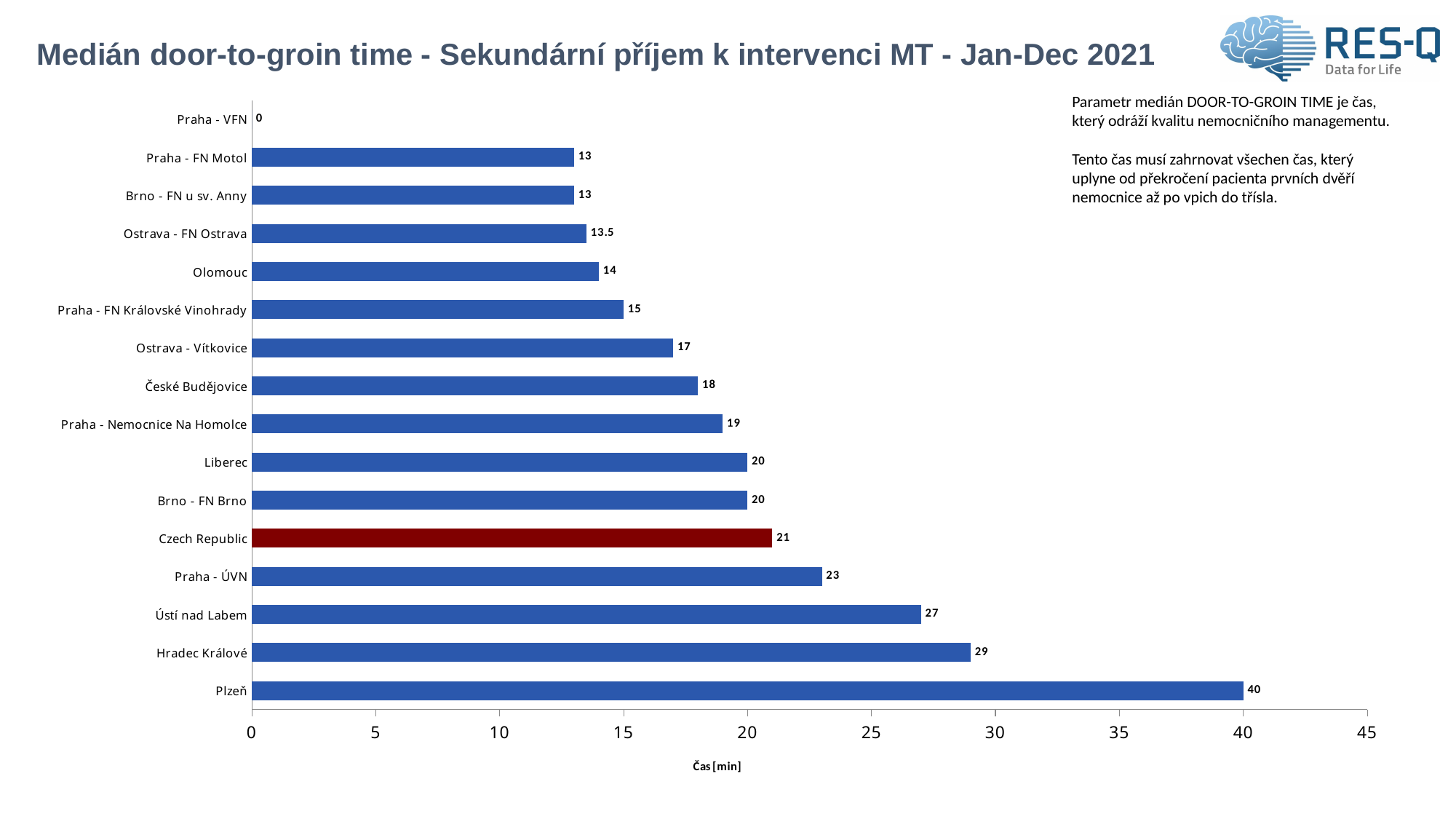
What is the median door-to-groin time for Plzeň? 40 What is the value shown for Czech Republic? 21 What kind of chart is shown on the slide? Bar chart What is the value shown for Ostrava - FN Ostrava? 13.5 How many categories are shown on the chart? 16 Which category's bar is coloured dark red instead of blue? Czech Republic What is the label of the horizontal axis? Čas [min] Which is larger, the value for Praha - ÚVN or the value for Liberec? Praha - ÚVN Is the value for Ústí nad Labem greater or less than 25? greater Which category has the lowest value? Praha - VFN What is the difference between the values for Plzeň and Hradec Králové? 11 Which category has the highest value? Plzeň